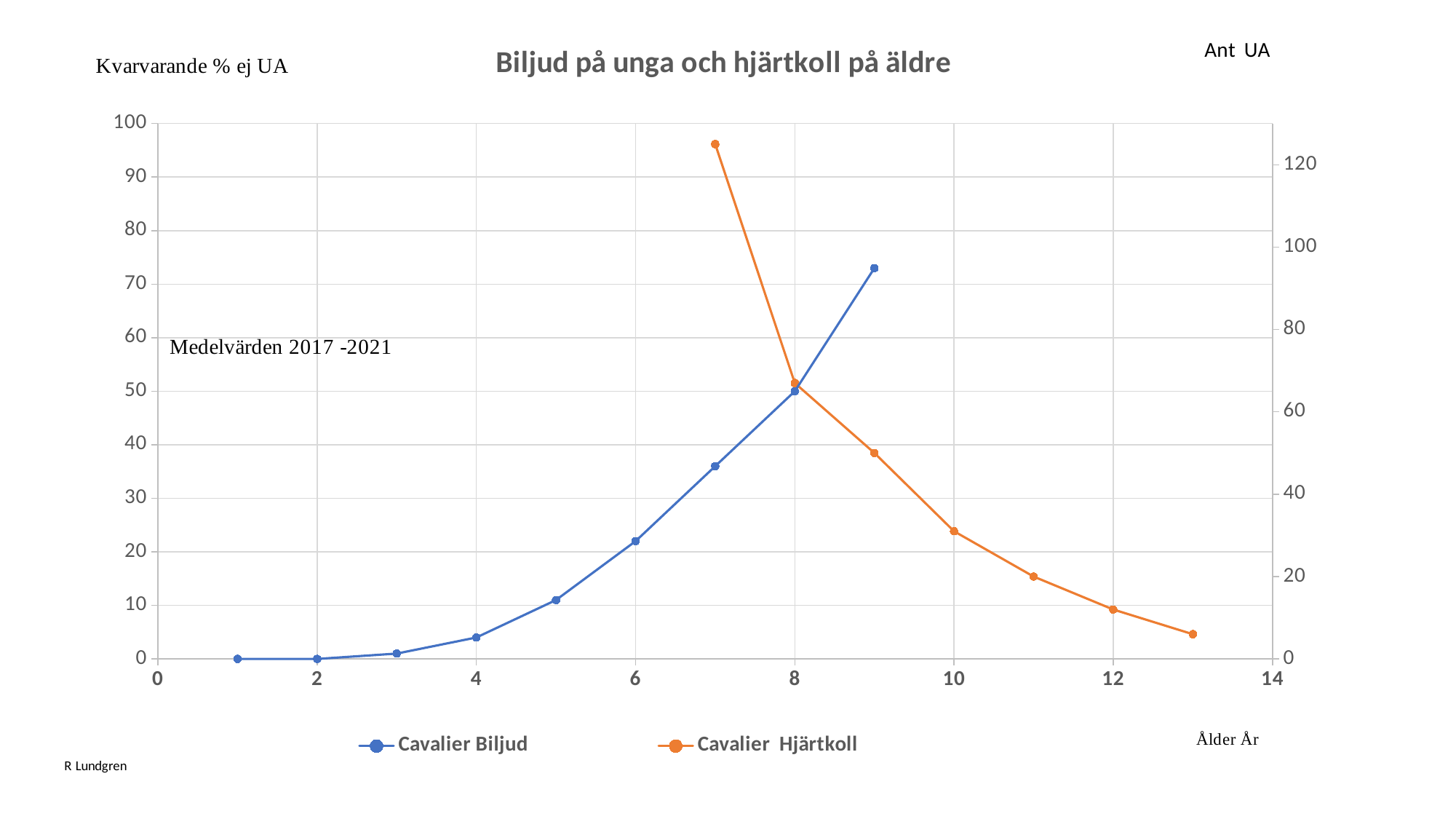
At which age does the Cavalier Biljud series reach its highest value? 9 How many series does the legend list? 2 Is the value for Cavalier Hjärtkoll at age 7 on the right axis greater or less than 120? greater Does the Cavalier Hjärtkoll series rise or fall as age increases? fall Which series is drawn in orange? Cavalier Hjärtkoll What kind of chart is shown on the slide? line chart What is the value of Cavalier Biljud at age 8 on the left axis? 50 Is the value for Cavalier Biljud at age 9 greater or less than 70? greater What is the title of the chart? Biljud på unga och hjärtkoll på äldre What is the value of Cavalier Biljud at age 1? 0 How many data points does the Cavalier Hjärtkoll series have? 7 Is the value for Cavalier Hjärtkoll at age 13 on the right axis greater or less than 20? less